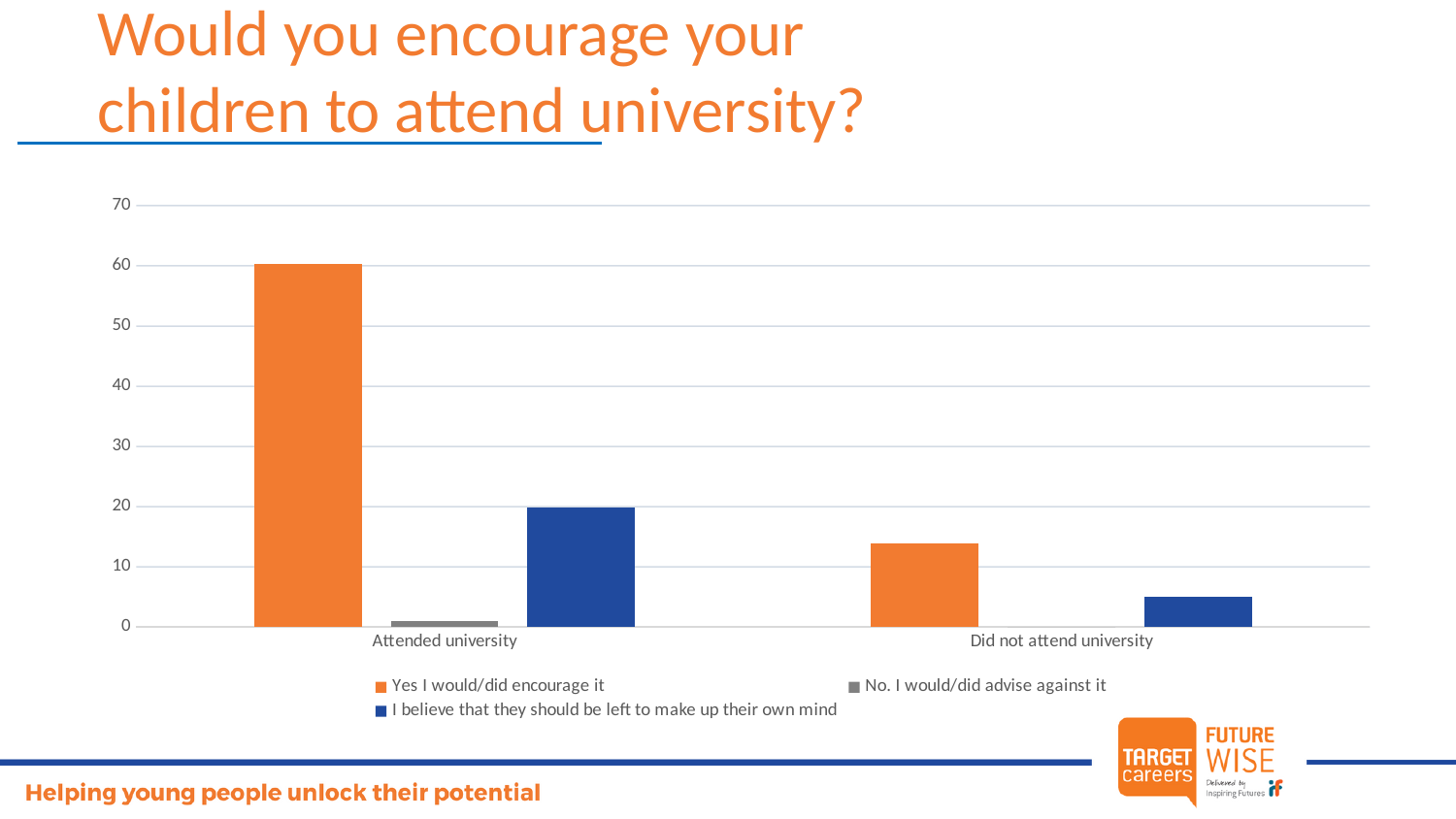
Is the value for 'I believe that they should be left to make up their own mind' among those who did not attend university greater or less than 10? less How many categories are shown on the x axis? 2 What kind of chart is shown on the slide? bar chart Is the value for 'I believe that they should be left to make up their own mind' among those who attended university greater or less than 10? greater Which is larger: 'Yes I would/did encourage it' for 'Attended university' or for 'Did not attend university'? Attended university Which response is lowest for the 'Attended university' category? No. I would/did advise against it What colour are the bars for 'Yes I would/did encourage it'? orange Which response is highest for the 'Did not attend university' category? Yes I would/did encourage it Is the value for 'Yes I would/did encourage it' among those who attended university greater or less than 50? greater Which response is highest for the 'Attended university' category? Yes I would/did encourage it How many series does the legend list? 3